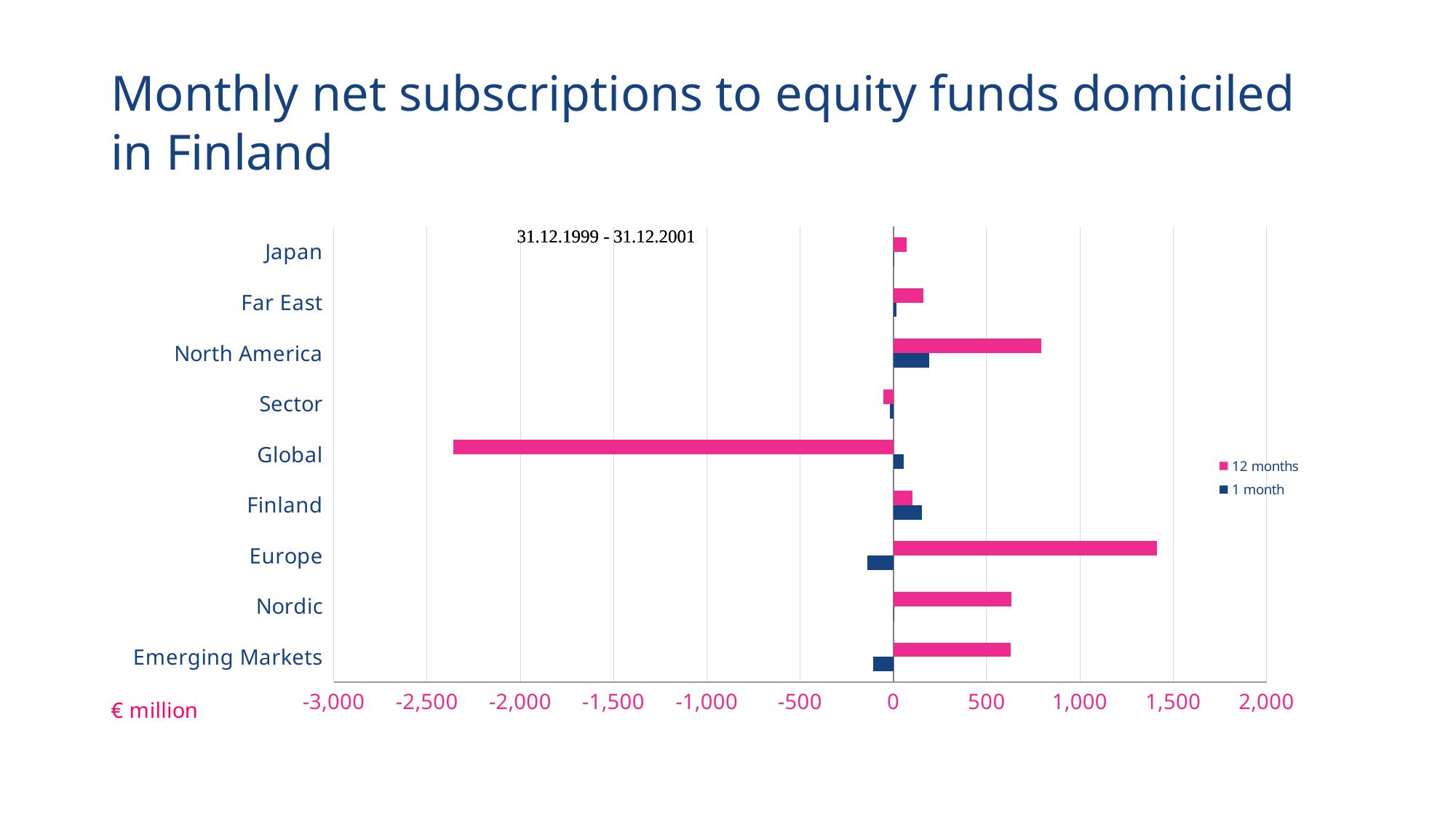
Which category has the highest value for the 12 months series? Europe Which category has the lowest value for the 12 months series? Global What unit is shown for the horizontal axis of the chart? € million Is the 12 months value for Europe greater or less than 1,000? greater Is the 12 months value for Nordic greater or less than 1,000? less How many categories are listed on the vertical axis of the chart? 9 How many series does the chart's legend list? 2 Is the 12 months value for North America greater or less than 500? greater Which has the larger 1 month value, Finland or Europe? Finland Which has the larger 12 months value, North America or Far East? North America What kind of chart is shown on the slide? Bar chart